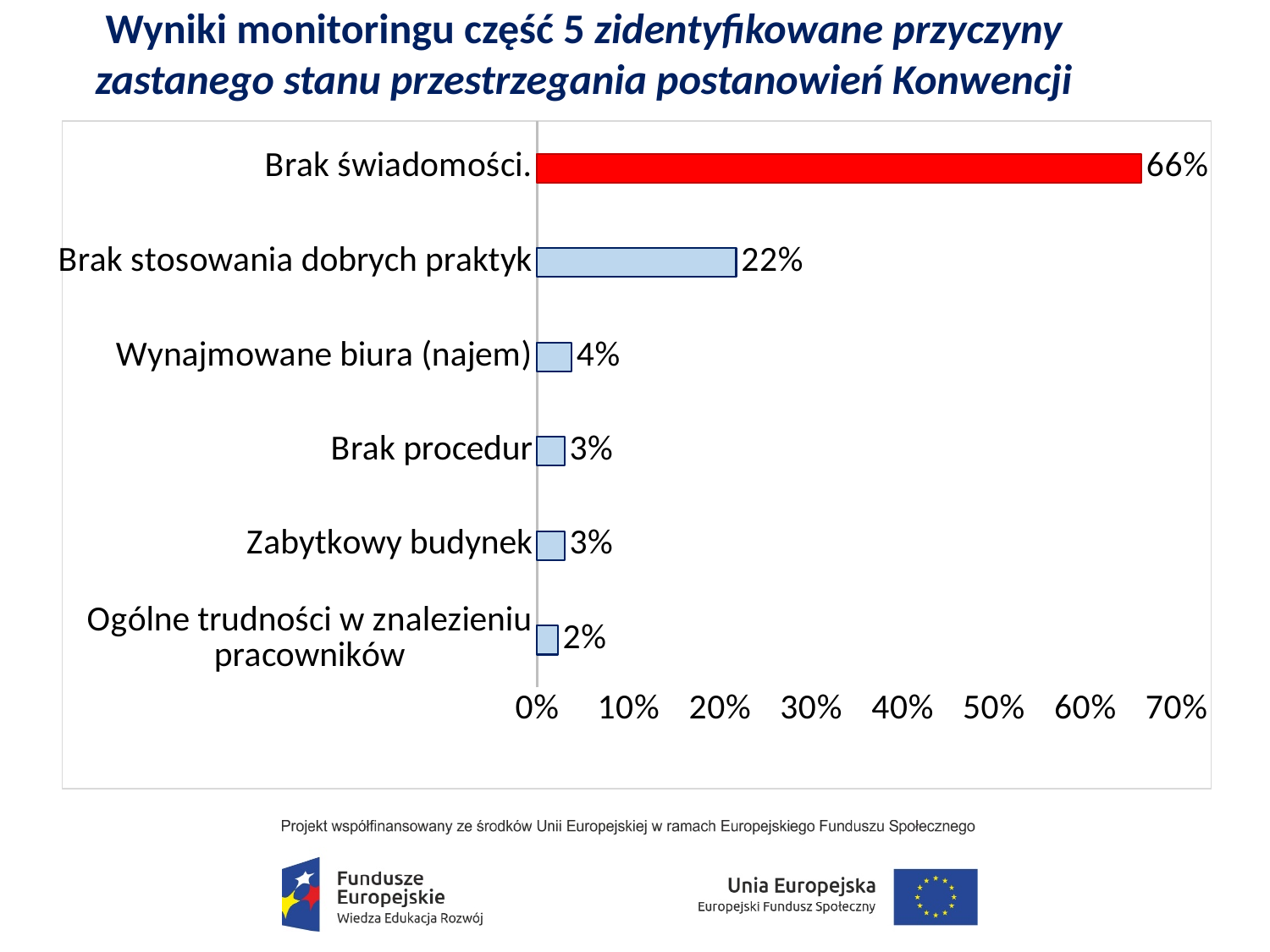
Which bar is coloured red? Brak świadomości. Which category has the highest value? Brak świadomości. What is the value for "Brak stosowania dobrych praktyk"? 22% How many categories are shown in the chart? 6 What is the value for "Wynajmowane biura (najem)"? 4% Which is larger, the value for "Wynajmowane biura (najem)" or the value for "Brak procedur"? Wynajmowane biura (najem) What is the value for "Brak świadomości."? 66% Is the value for "Brak świadomości." greater or less than 60%? greater What is the value for "Ogólne trudności w znalezieniu pracowników"? 2% Which category has the lowest value? Ogólne trudności w znalezieniu pracowników What kind of chart is shown on the slide? bar chart What is the difference between the values for "Brak świadomości." and "Brak stosowania dobrych praktyk"? 44%